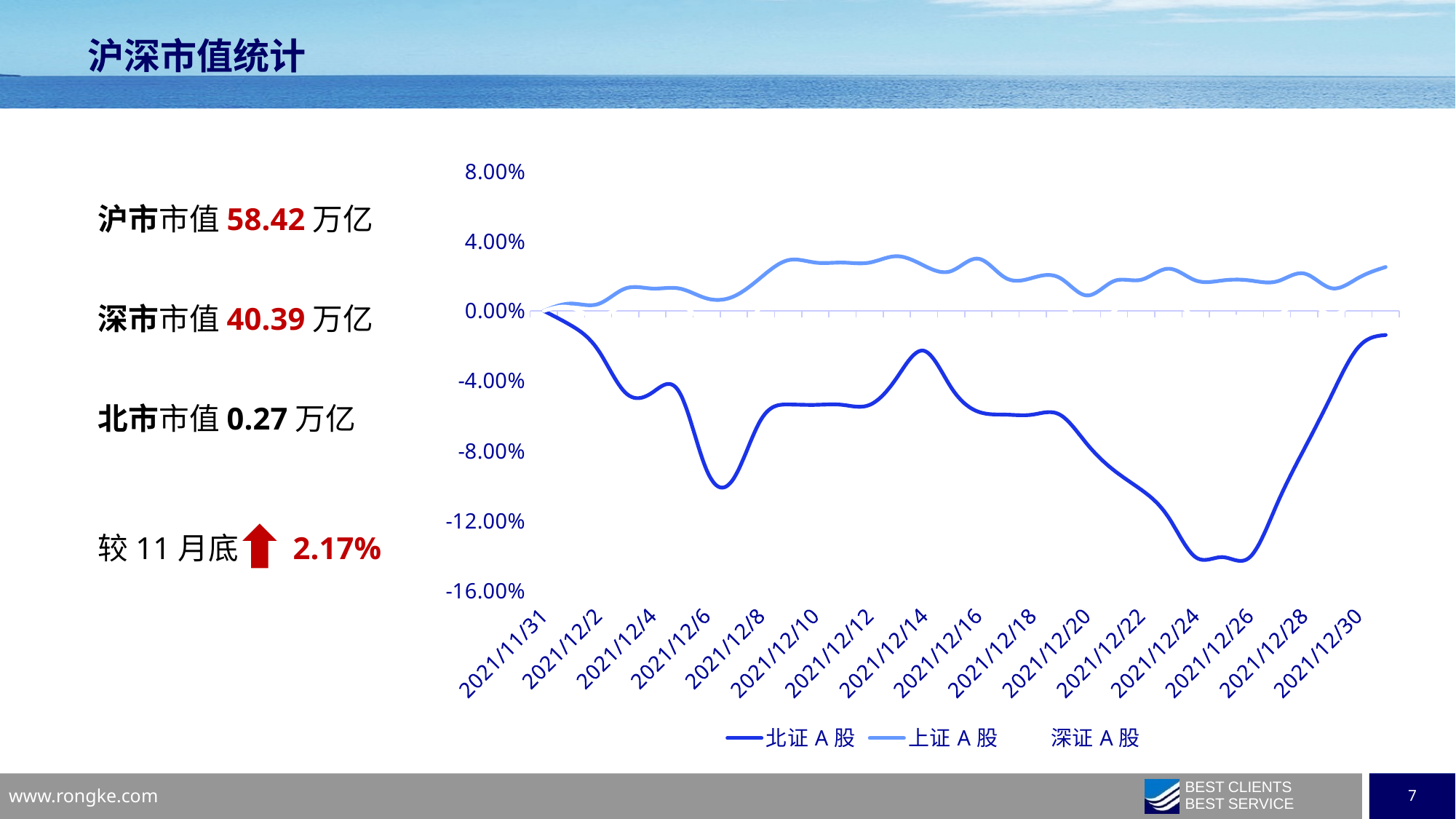
Which series has the higher value at 2021/12/26, 北证A股 or 上证A股? 上证A股 Is the value for 北证A股 at 2021/12/30 greater or less than -4.00%? greater Is the value for 上证A股 at 2021/12/14 greater or less than 0.00%? greater What kind of chart is shown on the slide? line chart Is the value for 北证A股 at 2021/12/14 greater or less than -4.00%? greater Which series are listed in the chart legend? 北证A股, 上证A股, 深证A股 What is the highest value shown on the chart's vertical axis? 8.00% How many series does the chart legend list? 3 Does the 北证A股 line rise or fall between 2021/12/26 and 2021/12/30? rise How many date labels are shown on the chart's x axis? 16